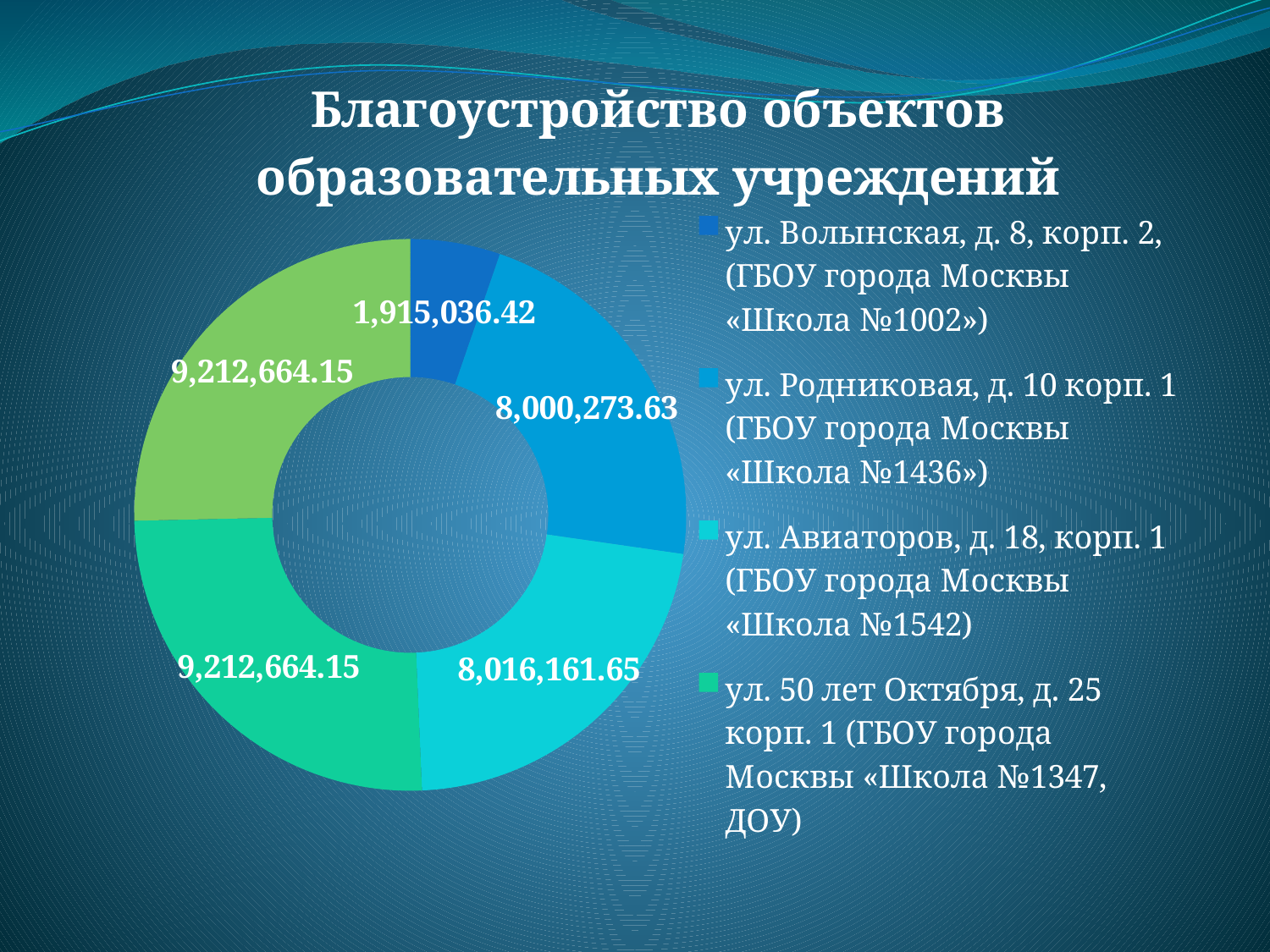
How many slices does the doughnut chart have? 5 What is the value of the dark blue slice (ул. Волынская, д. 8, корп. 2)? 1,915,036.42 What is the value of the blue slice (ул. Родниковая, д. 10 корп. 1)? 8,000,273.63 What is the difference between the largest slice (9,212,664.15) and the smallest slice (1,915,036.42)? 7,297,627.73 What is the title of the slide with the chart? Благоустройство объектов образовательных учреждений How many entries does the legend list? 4 What is the value of the cyan slice (ул. Авиаторов, д. 18, корп. 1)? 8,016,161.65 What is the smallest value shown on the chart? 1,915,036.42 What is the difference between the slice labelled 8,016,161.65 and the slice labelled 8,000,273.63? 15,888.02 What kind of chart is shown on the slide? Doughnut (pie) chart What is the largest value shown on the chart? 9,212,664.15 Which is larger: the value for ул. Авиаторов (8,016,161.65) or the value for ул. Родниковая (8,000,273.63)? ул. Авиаторов (8,016,161.65)